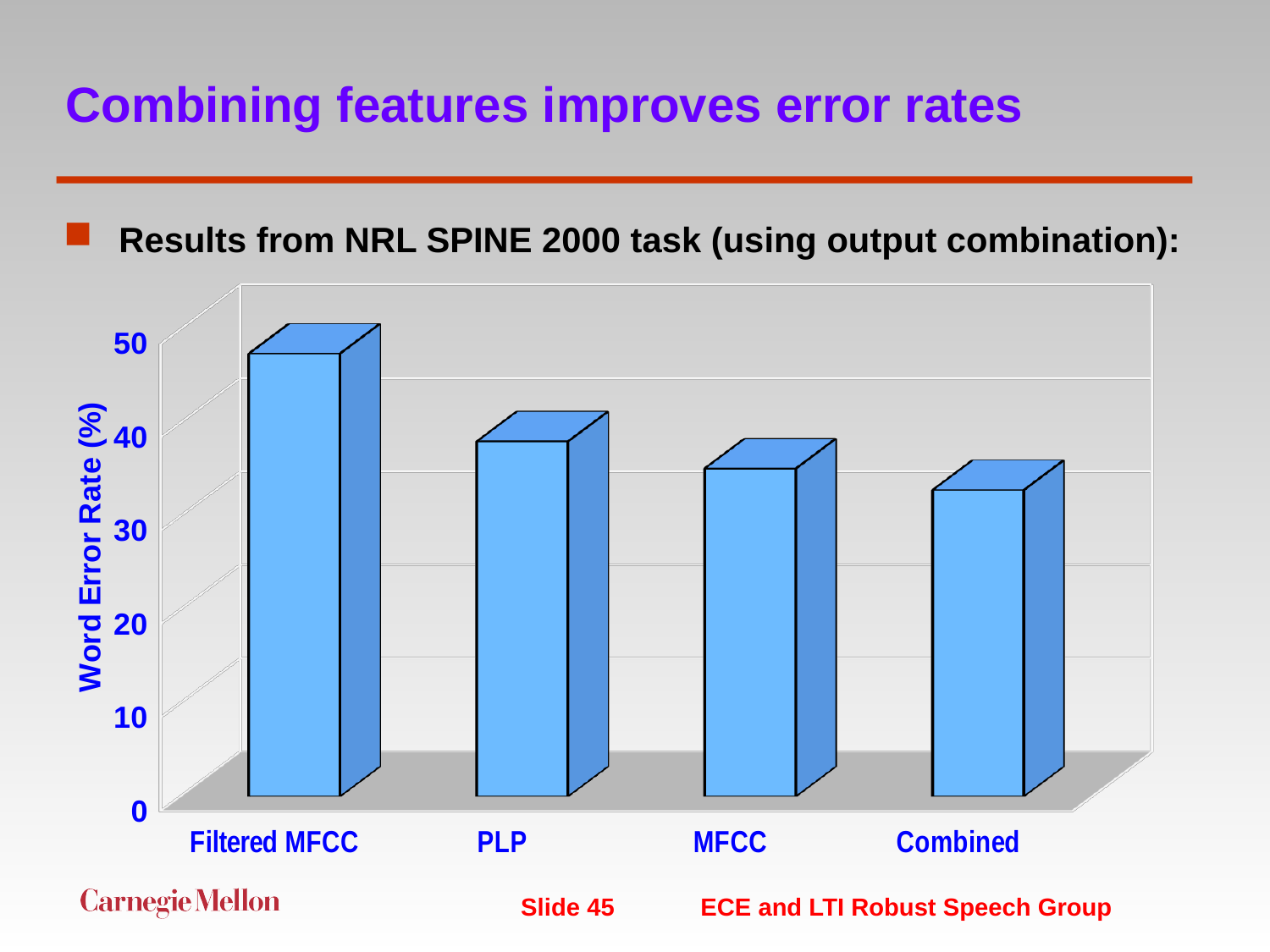
What kind of chart is shown on the slide? bar chart Which has a higher word error rate, Filtered MFCC or Combined? Filtered MFCC Which category has the lowest word error rate? Combined Is the word error rate for Combined greater or less than 40? less Is the word error rate for Filtered MFCC greater or less than 40? greater Is the word error rate for PLP greater or less than 30? greater Do the word error rates rise or fall moving from left to right across the categories? fall Which has a higher word error rate, PLP or MFCC? PLP What is the label on the vertical axis of the chart? Word Error Rate (%) How many categories are plotted on the x axis of the chart? 4 Which category has the highest word error rate? Filtered MFCC